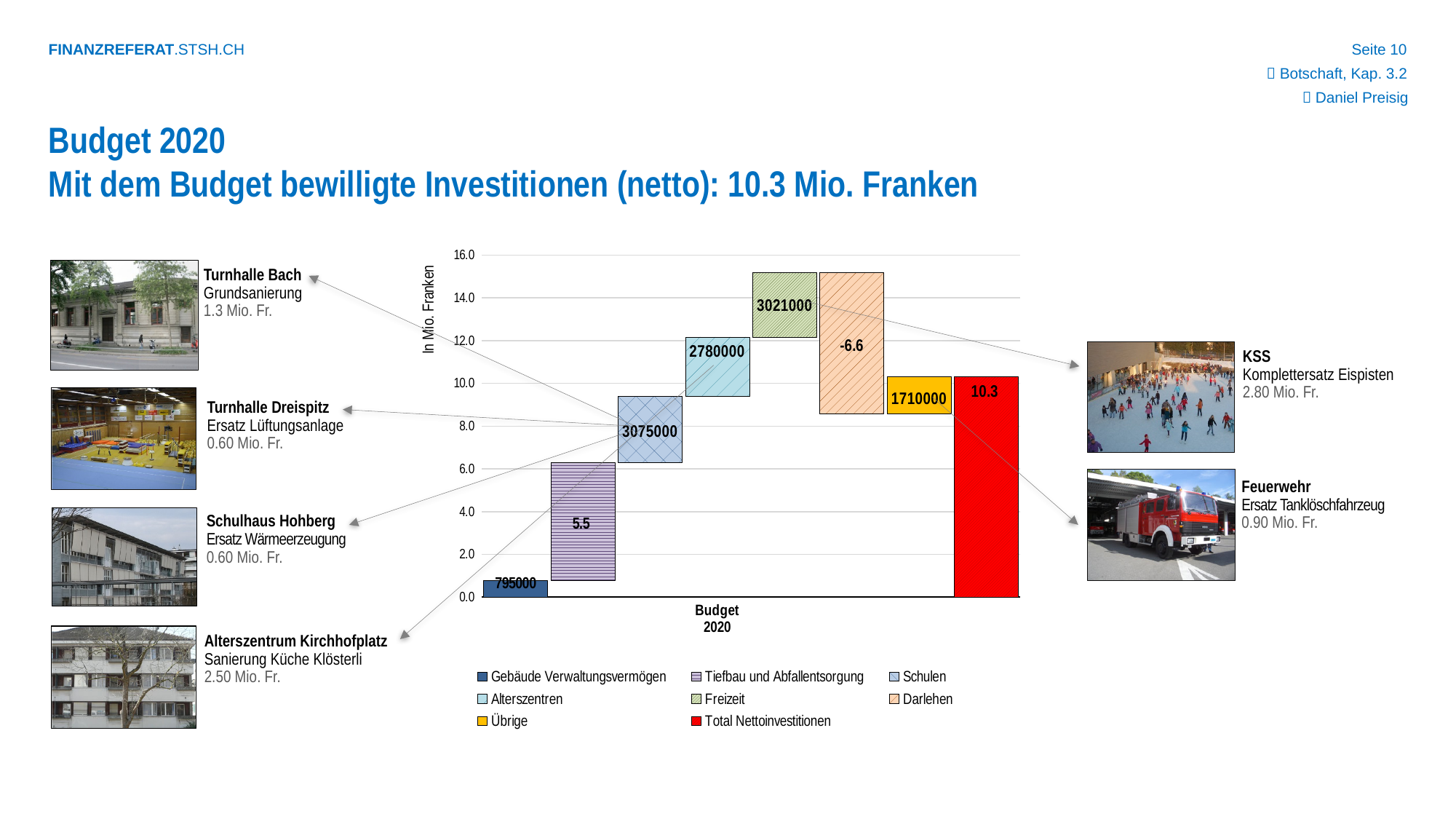
What is the difference between the Schulen value (3075000) and the Alterszentren value (2780000)? 295000 What value is labelled on the Total Nettoinvestitionen bar? 10.3 Which is larger, the Schulen value or the Alterszentren value? Schulen What kind of chart is shown on the slide? Bar chart Which series has a negative value in the chart? Darlehen What value is labelled on the Darlehen bar? -6.6 How many series does the legend list? 8 What is the label of the vertical axis? In Mio. Franken What value is labelled on the Gebäude Verwaltungsvermögen bar? 795000 What value is labelled on the Übrige bar? 1710000 What value is labelled on the Schulen bar? 3075000 What value is labelled on the Tiefbau und Abfallentsorgung bar? 5.5